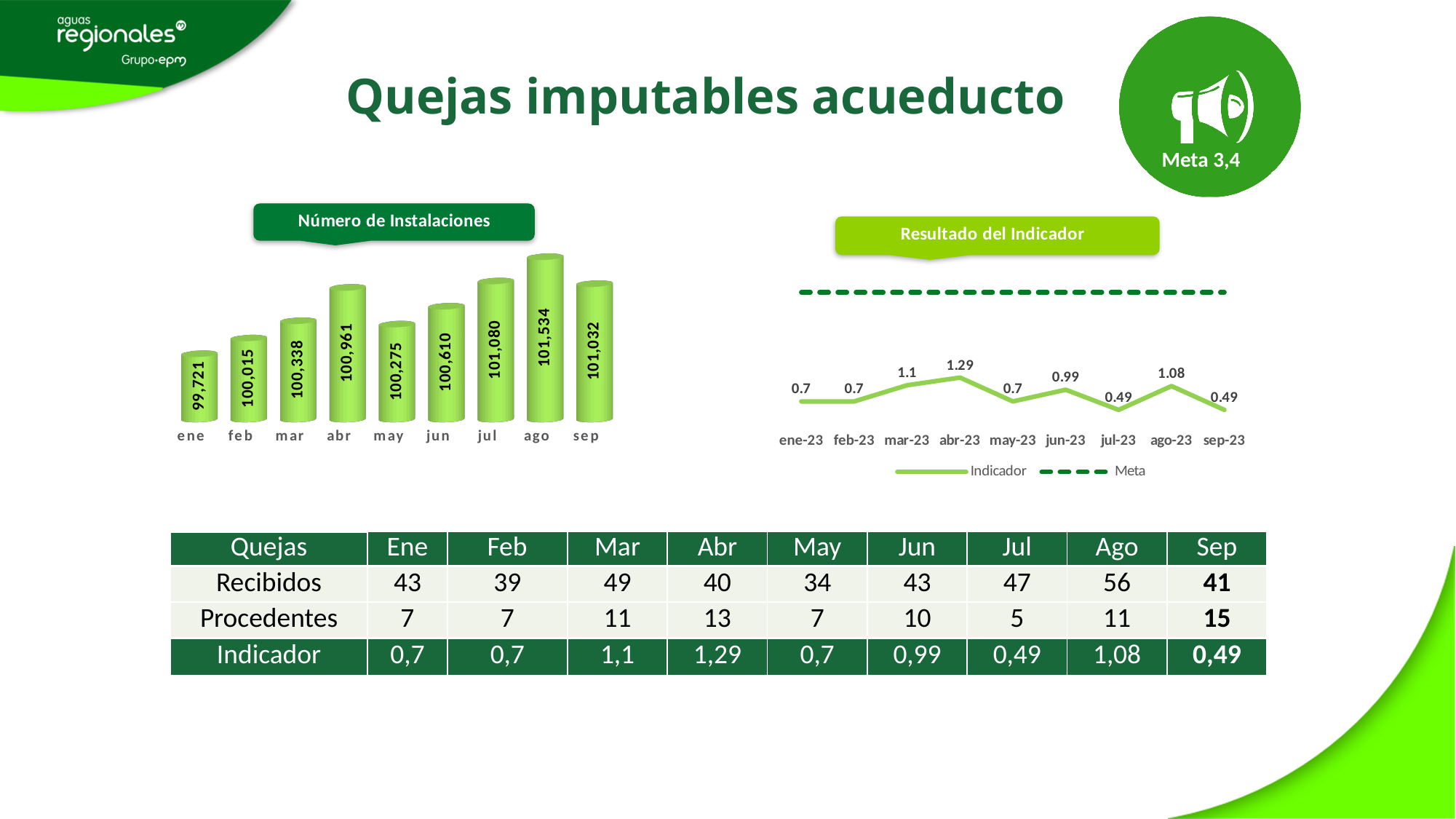
In the 'Número de Instalaciones' chart, what is the difference between the values for ago and jul? 454 How many series does the legend of the 'Resultado del Indicador' chart list? 2 In the 'Resultado del Indicador' chart, what is the Indicador value for abr-23? 1.29 In the 'Número de Instalaciones' chart, which month has the lowest value? ene In the 'Resultado del Indicador' chart, which month has the highest Indicador value? abr-23 In the 'Número de Instalaciones' chart, what is the value for abr? 100,961 In the 'Resultado del Indicador' chart, does the Indicador value rise or fall from ago-23 to sep-23? fall In the 'Número de Instalaciones' chart, which is larger, the value for may or the value for jun? jun What kind of chart is the 'Número de Instalaciones' chart? bar chart In the 'Resultado del Indicador' chart, what is the difference between the Indicador values for ago-23 and sep-23? 0.59 In the 'Número de Instalaciones' chart, which month has the highest value? ago How many months are shown in the 'Número de Instalaciones' chart? 9